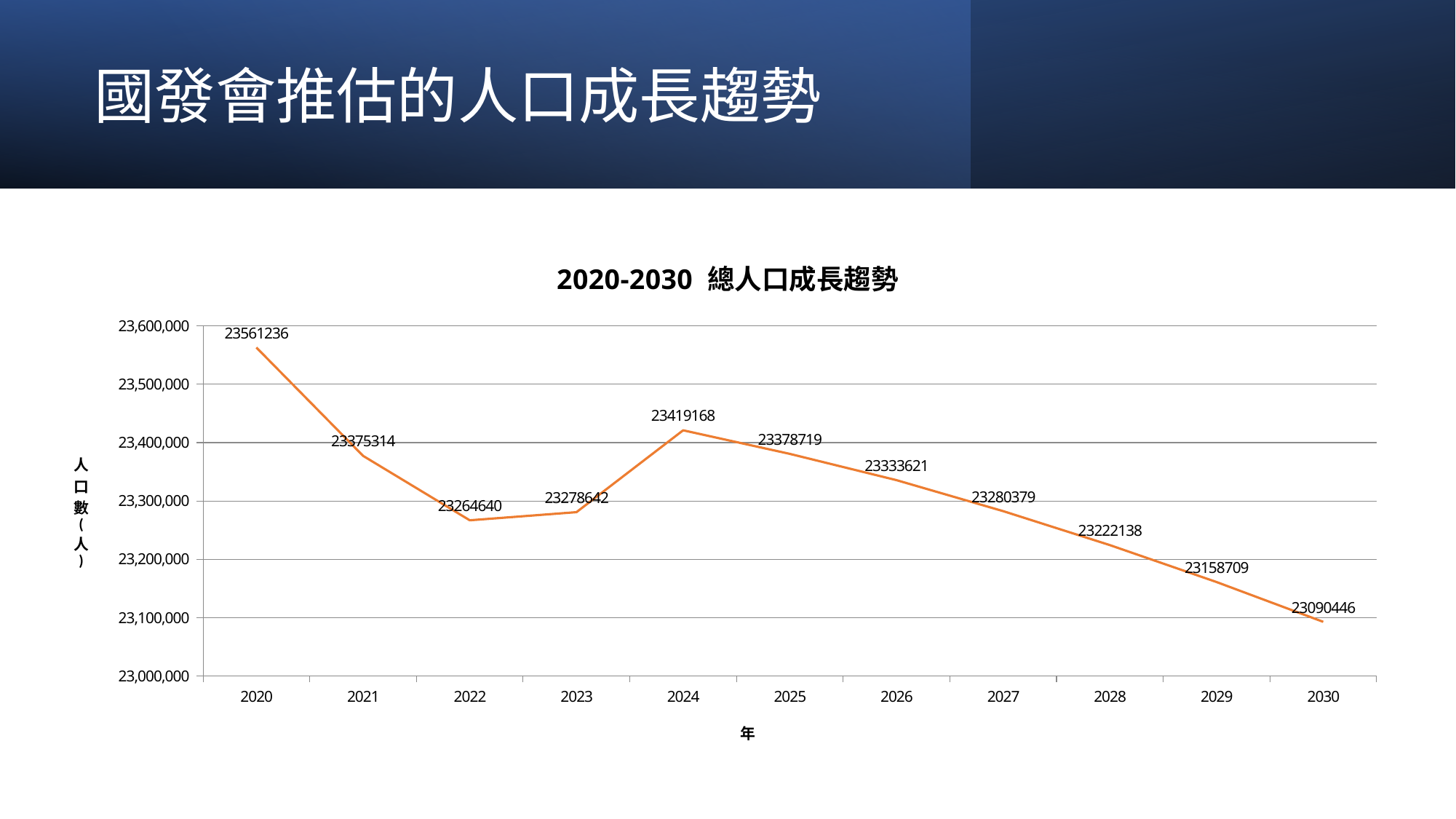
Which year has the lowest population value on the chart? 2030 What is the population value shown for 2030? 23090446 What is the population value shown for 2024? 23419168 What kind of chart is shown on the slide? line chart Is the value for 2030 greater or less than 23,100,000? less What is the population value shown for 2020? 23561236 What is the title of the chart? 2020-2030 總人口成長趨勢 What is the difference between the population values for 2020 and 2030? 470790 Which year has the larger population value, 2022 or 2023? 2023 What is the difference between the population values for 2024 and 2023? 140526 Which year has the highest population value on the chart? 2020 How many years are plotted on the chart? 11